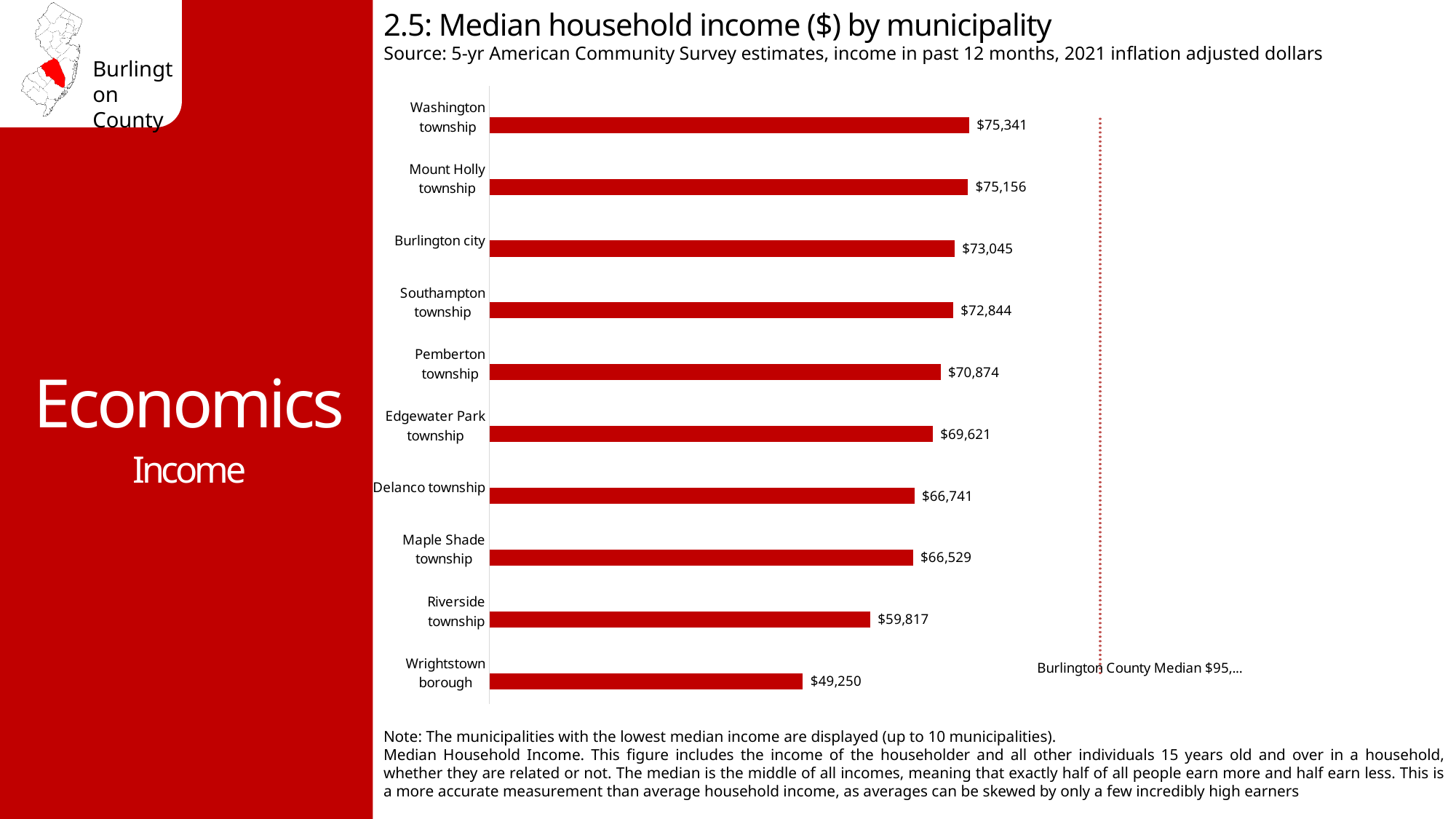
What kind of chart is used to show median household income by municipality? Bar chart What is the difference between the median household income of Riverside township and Wrightstown borough? $10,567 What is the median household income shown for Pemberton township? $70,874 What is the median household income shown for Washington township? $75,341 Which municipality has the lowest median household income on the chart? Wrightstown borough What is the median household income shown for Wrightstown borough? $49,250 Which has a higher median household income, Delanco township or Maple Shade township? Delanco township What is the difference between the median household income of Washington township and Wrightstown borough? $26,091 How many municipalities are shown on the chart? 10 What is the median household income shown for Riverside township? $59,817 What does the dotted vertical line on the chart represent? Burlington County Median Which municipality has the highest median household income on the chart? Washington township